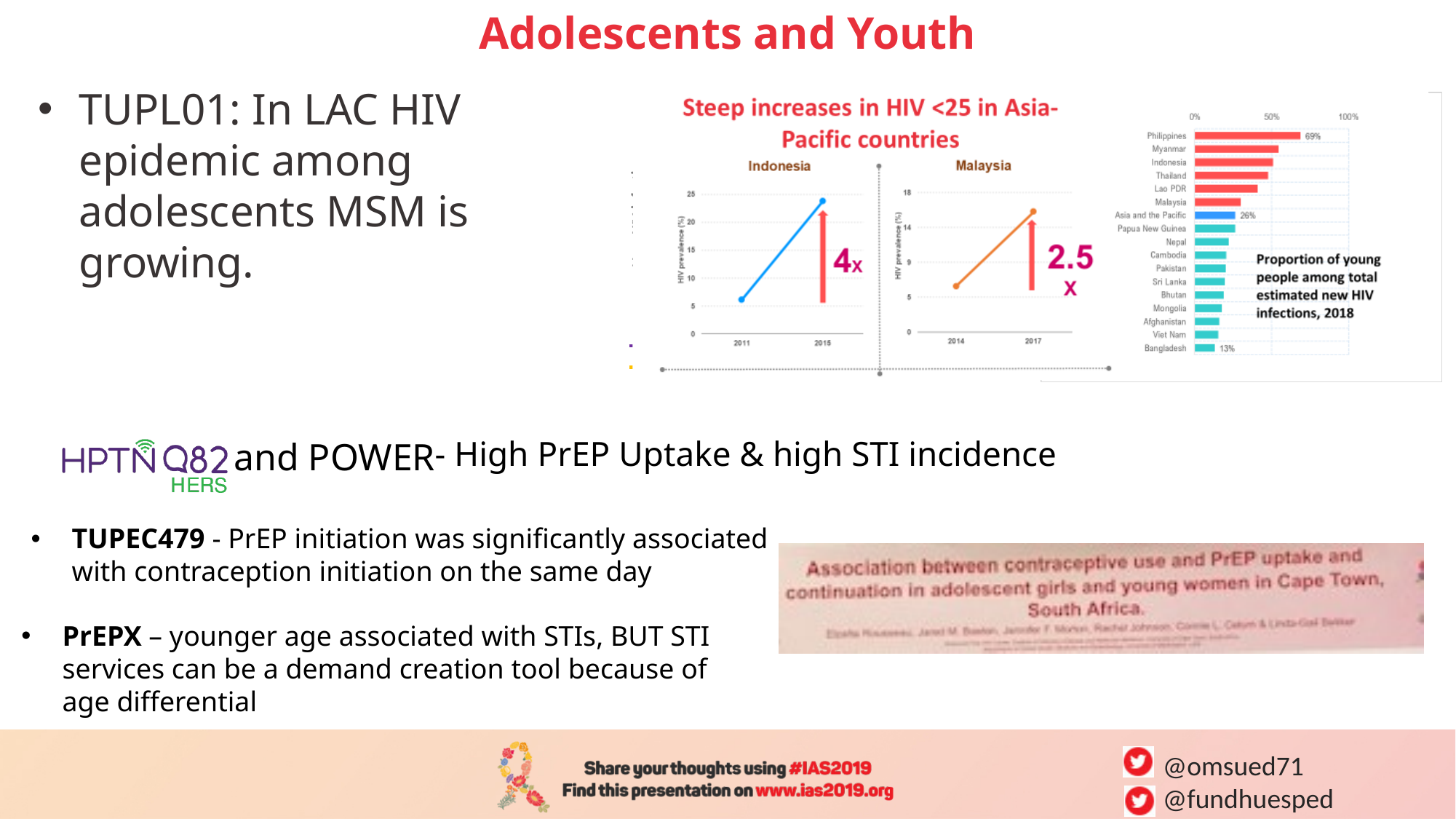
In the bar chart on the right (Proportion of young people among total estimated new HIV infections, 2018), what is the value for Philippines? 69% In the bar chart on the right, what is the value for Asia and the Pacific? 26% In the Indonesia chart, does HIV prevalence rise or fall from 2011 to 2015? Rise What kind of chart is the Malaysia chart? Line chart How many bars are shown in the bar chart on the right? 17 In the bar chart on the right, what is the difference between the values for Philippines and Bangladesh? 56% In the bar chart on the right, is the value for Malaysia greater or less than 50%? less In the bar chart on the right, which has the larger value, Myanmar or Viet Nam? Myanmar In the bar chart on the right, which country has the highest proportion? Philippines What kind of chart is the chart on the right showing the proportion of young people among new HIV infections? Bar chart In the bar chart on the right, what is the value for Bangladesh? 13% In the bar chart on the right, which country has the lowest proportion? Bangladesh